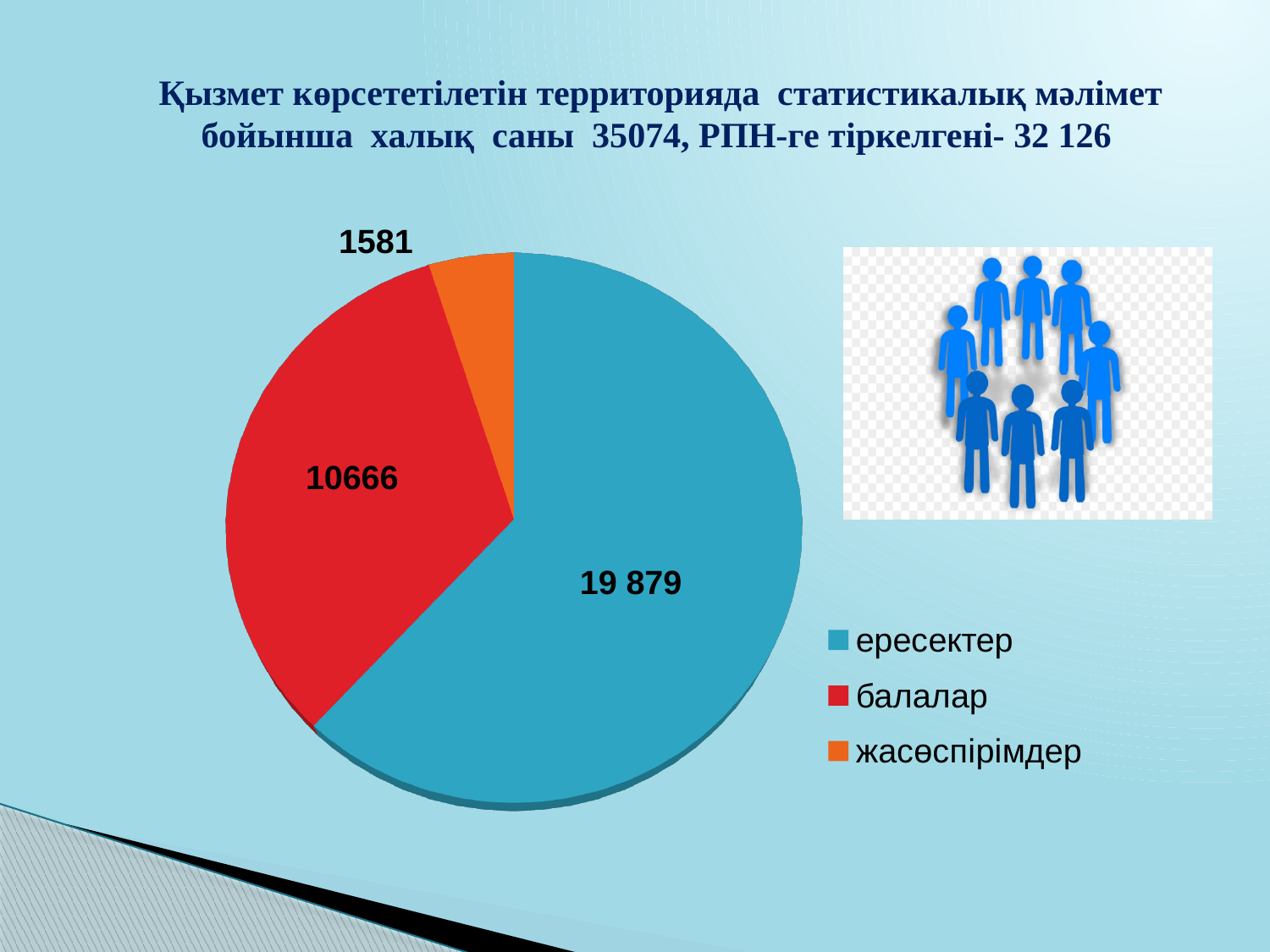
What is the value for балалар in the pie chart? 10666 Which category has the largest slice in the pie chart? ересектер Which is larger, the value for балалар or the value for жасөспірімдер? балалар How many slices does the pie chart have? 3 What is the value for ересектер in the pie chart? 19 879 What is the difference between the values for балалар and жасөспірімдер? 9085 What colour is the slice for балалар? red What kind of chart is shown on the slide? pie chart Which category has the smallest slice in the pie chart? жасөспірімдер What is the difference between the values for ересектер and балалар? 9213 What is the value for жасөспірімдер in the pie chart? 1581 How many entries does the legend list? 3